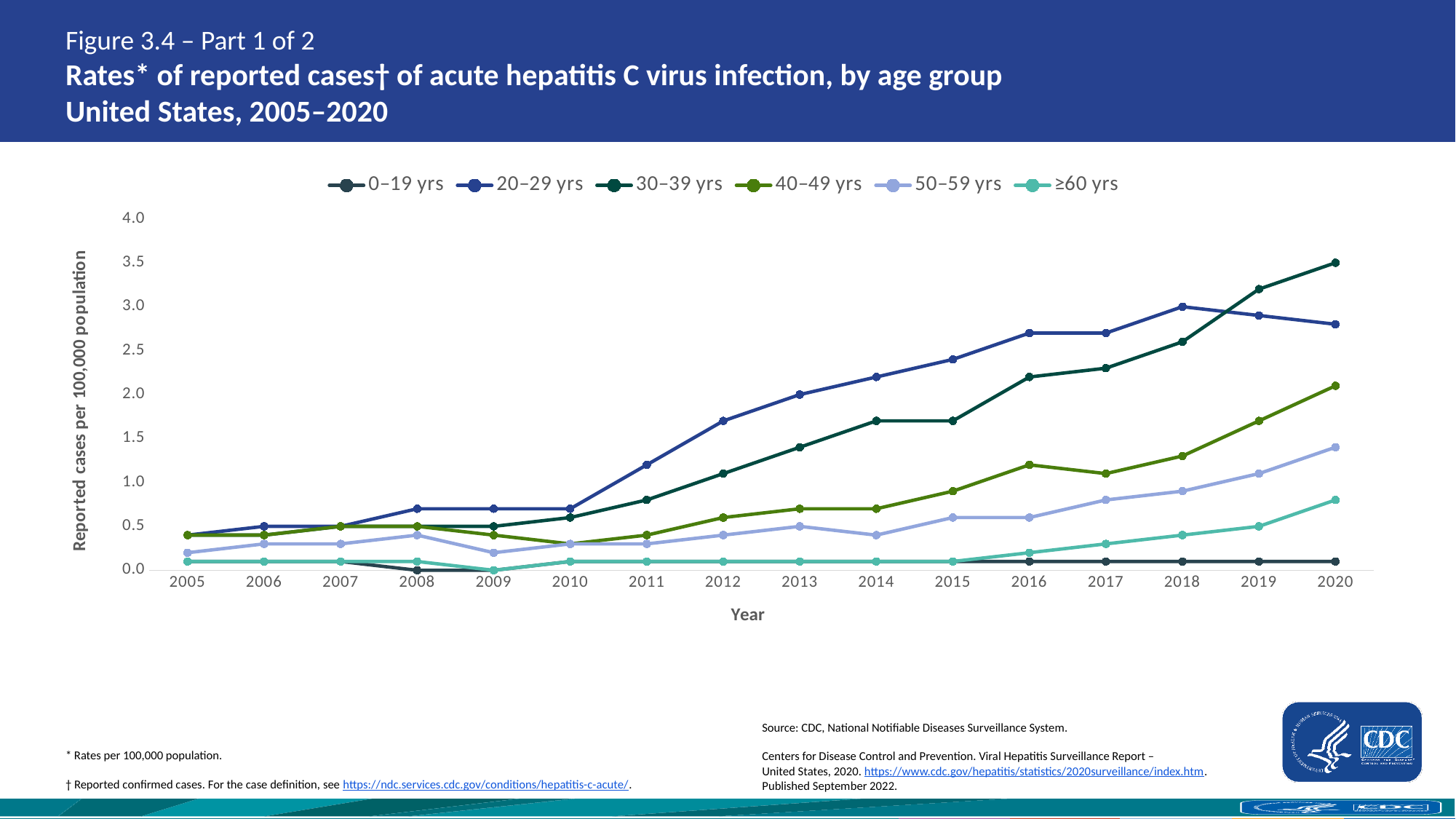
In 2018, which is larger: the rate for 20–29 yrs or the rate for 30–39 yrs? 20–29 yrs Which age group has the highest rate in 2020? 30–39 yrs How many age-group series does the legend list? 6 Does the rate for 30–39 yrs rise or fall from 2010 to 2020? Rise Which age group has the highest rate in 2015? 20–29 yrs Which age group has the lowest rate in 2020? 0–19 yrs Is the value for 30–39 yrs in 2020 greater or less than 3.0? greater What is the label of the y axis? Reported cases per 100,000 population How many years are plotted along the x axis? 16 What kind of chart is shown on the slide? Line chart Is the value for ≥60 yrs in 2020 greater or less than 1.0? less In 2020, which is larger: the rate for 40–49 yrs or the rate for 50–59 yrs? 40–49 yrs